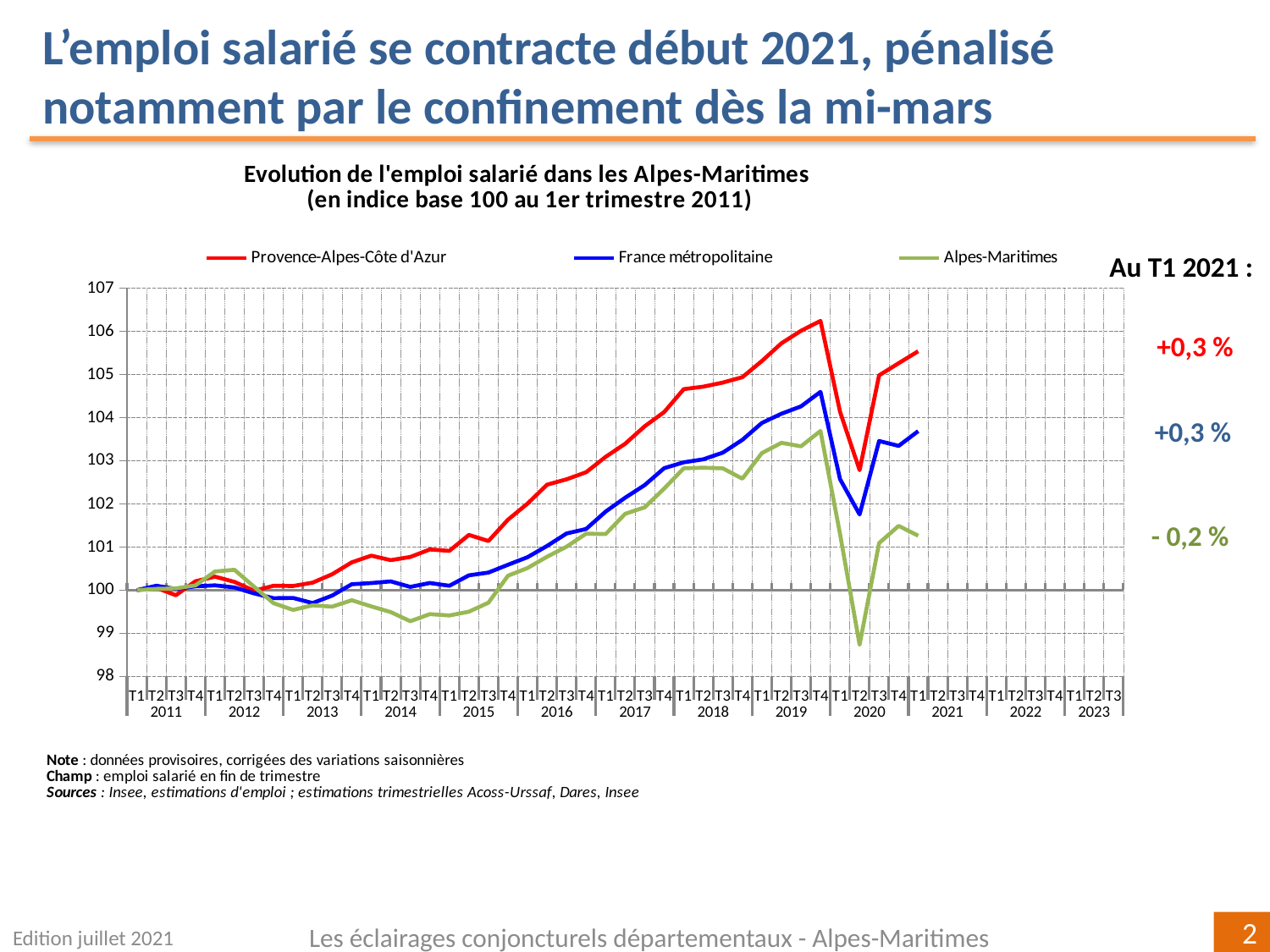
Which series is drawn in red? Provence-Alpes-Côte d'Azur Which series has the highest value at T4 2019? Provence-Alpes-Côte d'Azur Which series has the lowest value at T2 2020? Alpes-Maritimes Is the value for Alpes-Maritimes at T2 2020 greater or less than 100? less Is the value for France métropolitaine at T2 2020 greater or less than 103? less What kind of chart is shown on the slide? line chart How many series does the legend list? 3 At T1 2021, which is higher: France métropolitaine or Alpes-Maritimes? France métropolitaine Does the Provence-Alpes-Côte d'Azur series rise or fall between T1 2015 and T4 2019? rise What is the title of the chart? Evolution de l'emploi salarié dans les Alpes-Maritimes (en indice base 100 au 1er trimestre 2011) Is the value for Provence-Alpes-Côte d'Azur at T4 2019 greater or less than 105? greater What change is annotated for Alpes-Maritimes at T1 2021? - 0,2 %